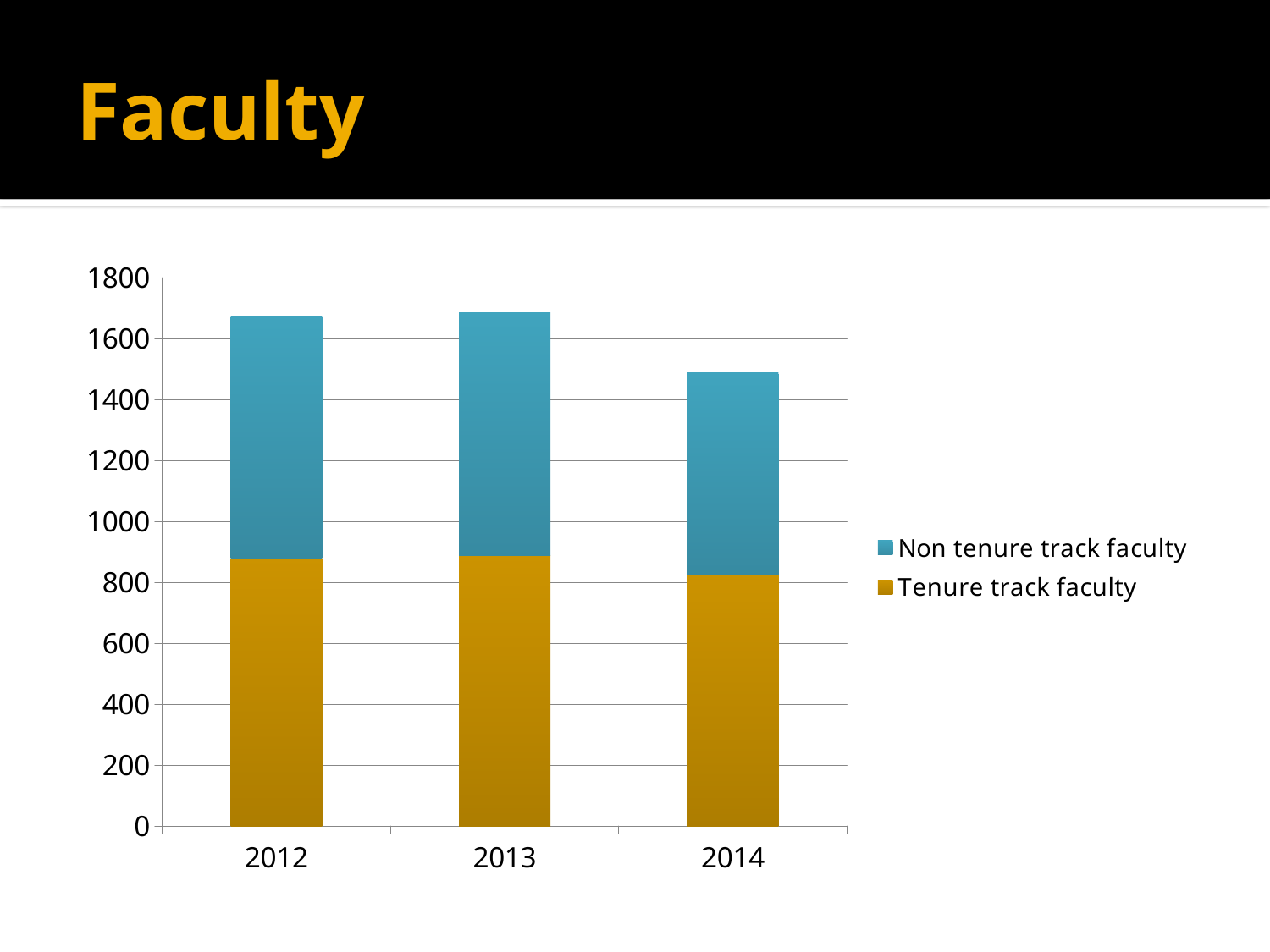
Is the total faculty bar for 2014 greater or less than 1600? less How many years are shown on the x axis of the chart? 3 Which year has the lowest Tenure track faculty value? 2014 Which year has the larger total faculty bar, 2012 or 2014? 2012 Is the Tenure track faculty value for 2012 greater or less than 800? greater What kind of chart is shown on the slide? Stacked bar chart Which year has the lowest total faculty bar? 2014 Is the total faculty bar for 2012 greater or less than 1600? greater How many series does the chart's legend list? 2 Which series is shown in the gold/orange colour at the bottom of each bar? Tenure track faculty Does the total faculty bar rise or fall from 2013 to 2014? fall